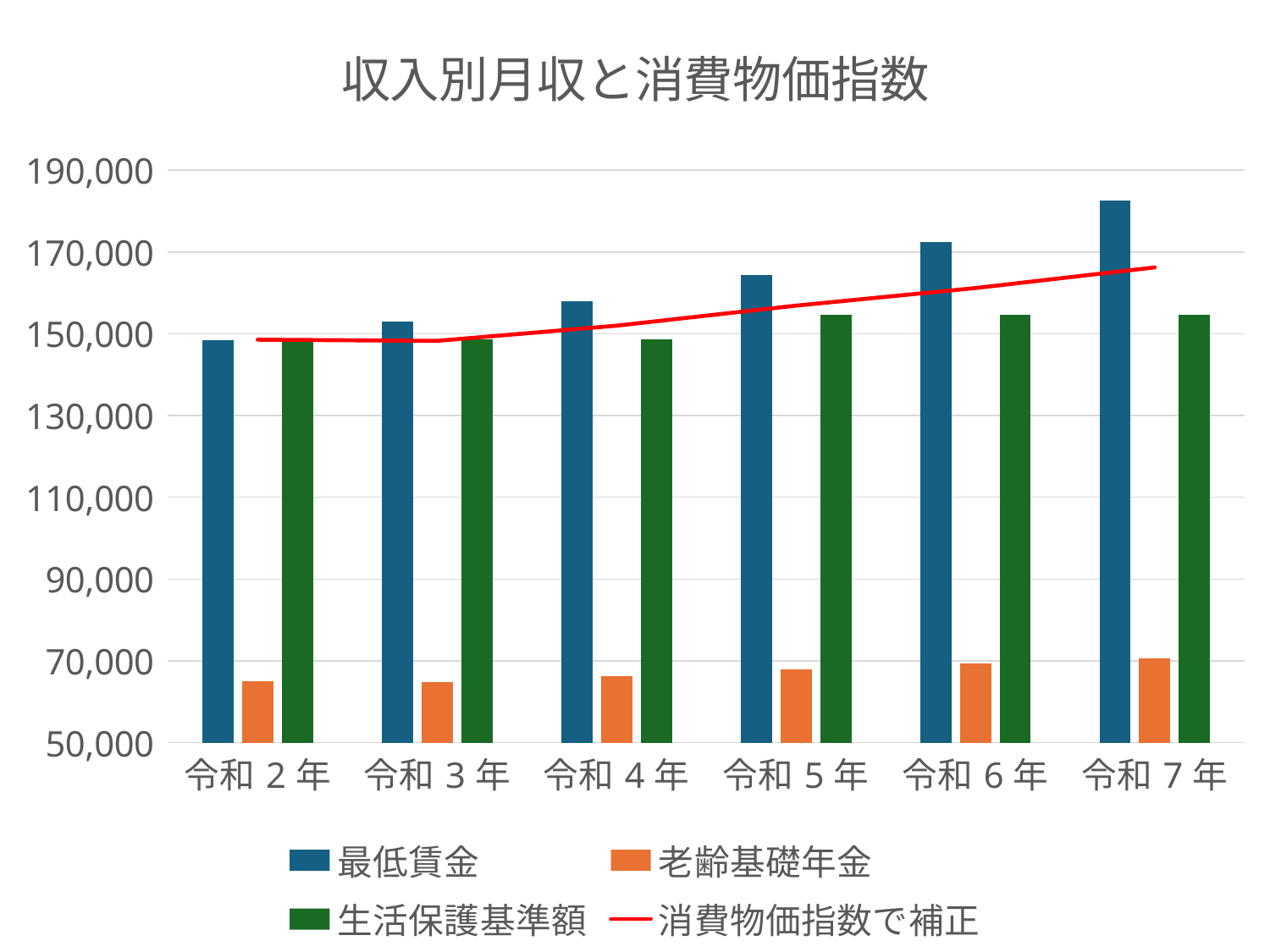
How many series does the legend list? 4 Is the 老齢基礎年金 value for 令和２年 greater or less than 70,000? less In which year is the 最低賃金 bar the highest? 令和７年 How many categories (years) are shown on the x axis? 6 Does the red 消費物価指数で補正 line rise or fall from 令和３年 to 令和７年? Rise Is the 最低賃金 value for 令和７年 greater or less than 170,000? greater Is the 生活保護基準額 value for 令和５年 greater or less than 150,000? greater In which year is the 最低賃金 bar the lowest? 令和２年 Do the 最低賃金 values rise or fall from 令和２年 to 令和７年? Rise What is the title of the chart? 収入別月収と消費物価指数 What kind of chart is shown on the slide? Bar chart with a line In 令和７年, which is larger: 最低賃金 or 生活保護基準額? 最低賃金